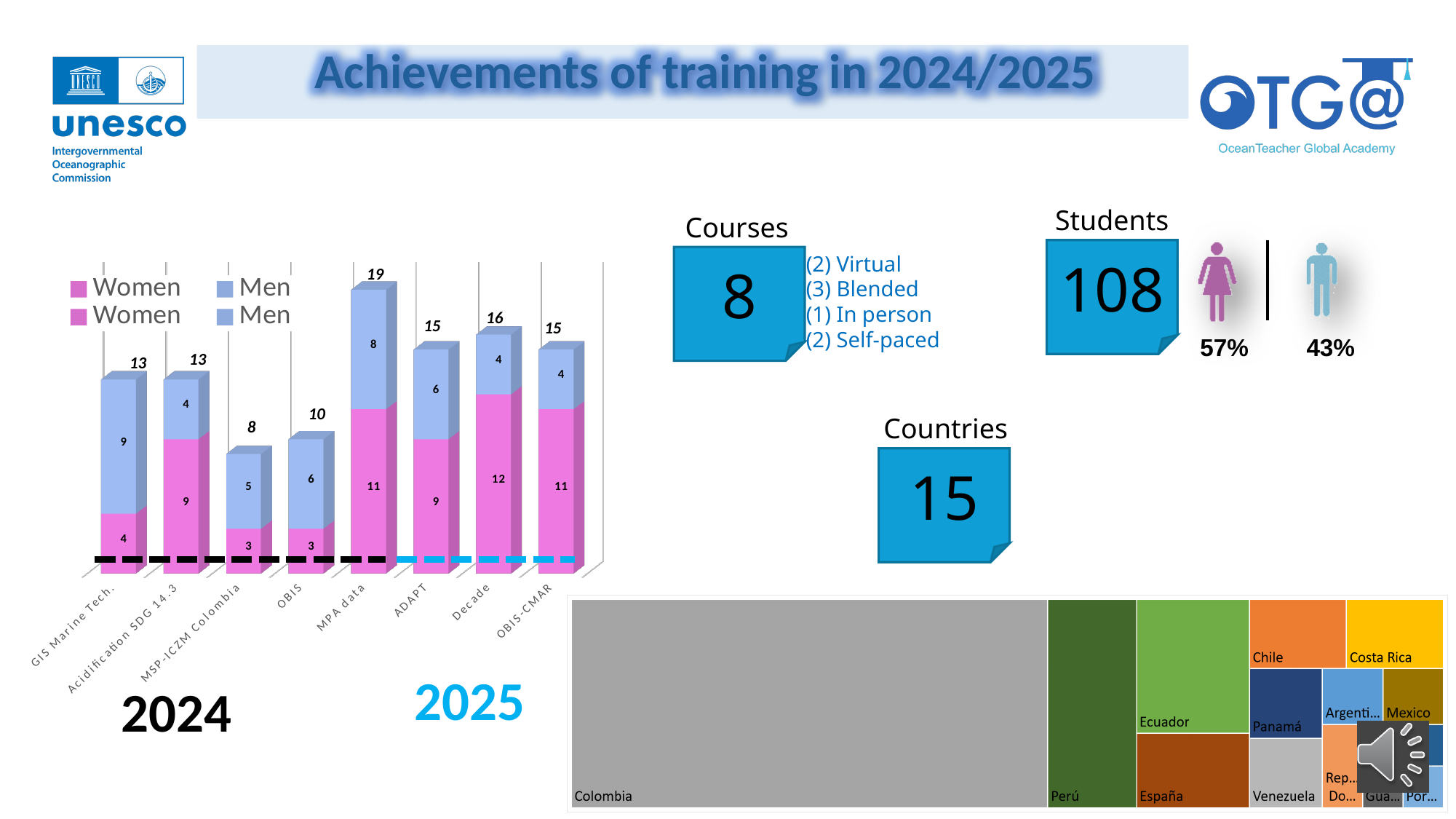
In the stacked bar chart, which is larger for the OBIS course: the number of women or the number of men? Men In the stacked bar chart, what is the total number of participants for the Decade course? 16 In the stacked bar chart, how many women attended the MPA data course? 11 In the stacked bar chart, how many men attended the GIS Marine Tech. course? 9 What type of chart is used to show Women and Men participants per course? Stacked bar chart In the stacked bar chart, which course has the lowest total number of participants? MSP-ICZM Colombia How many courses (categories) are shown in the stacked bar chart? 8 In the stacked bar chart, which course has the highest total number of participants? MPA data In the stacked bar chart, what is the difference between the number of women and men in the Acidification SDG 14.3 course? 5 In the treemap of countries at the bottom right, which country occupies the largest area? Colombia In the stacked bar chart, which colour represents Women? Pink In the stacked bar chart, what is the total number of participants for the ADAPT course? 15